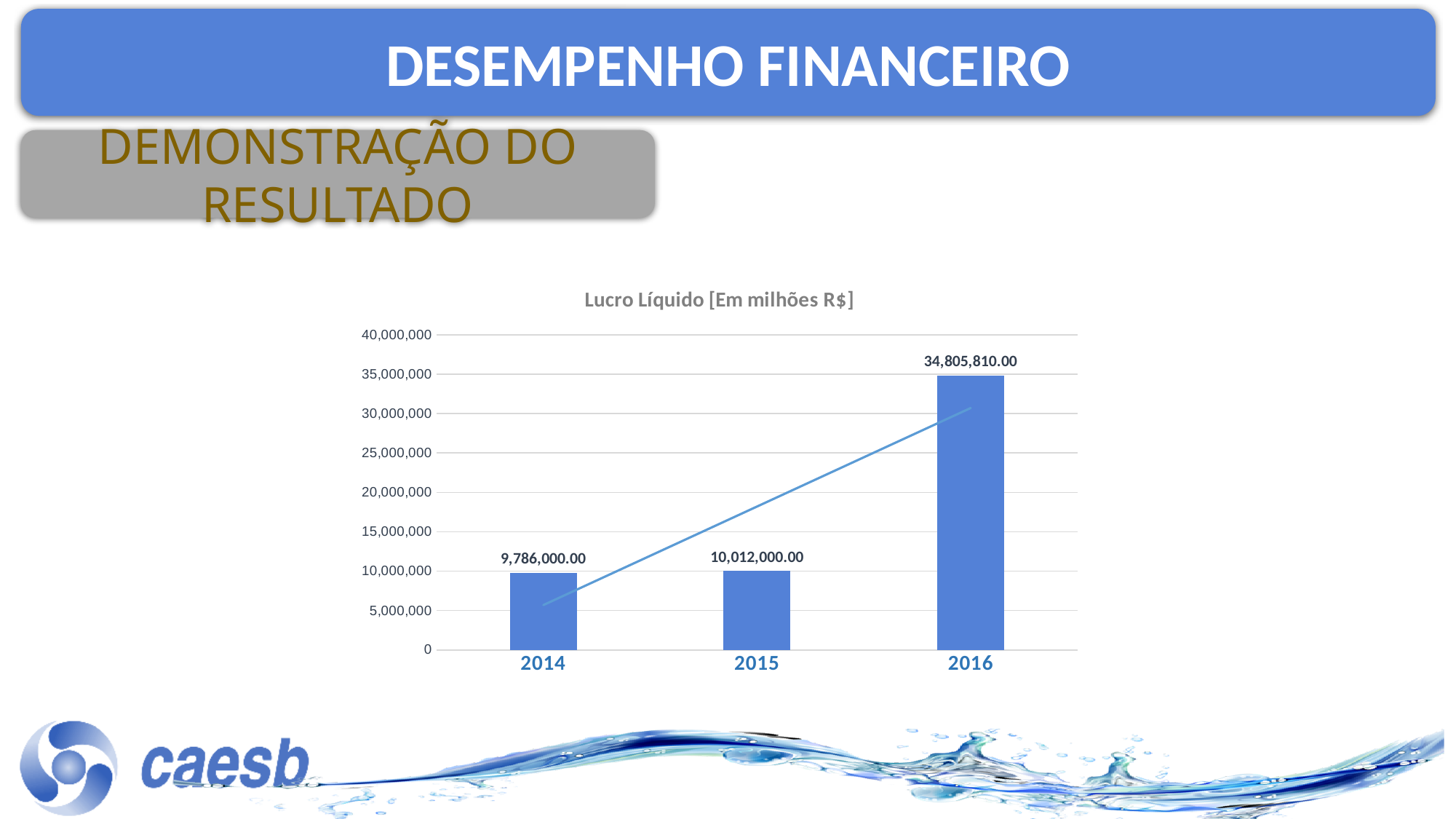
Is the value for 2016 greater or less than 30,000,000? greater What kind of chart is used to show Lucro Líquido? bar chart What is the title of the chart on the slide? Lucro Líquido [Em milhões R$] What is the value for 2014 in the Lucro Líquido chart? 9,786,000.00 What is the value for 2016 in the Lucro Líquido chart? 34,805,810.00 Which is larger, the Lucro Líquido for 2016 or for 2014? 2016 What is the value for 2015 in the Lucro Líquido chart? 10,012,000.00 What is the difference between the Lucro Líquido values for 2016 and 2015? 24,793,810.00 What is the difference between the Lucro Líquido values for 2015 and 2014? 226,000.00 Which year has the highest Lucro Líquido? 2016 How many years are shown in the Lucro Líquido chart? 3 Which year has the lowest Lucro Líquido? 2014